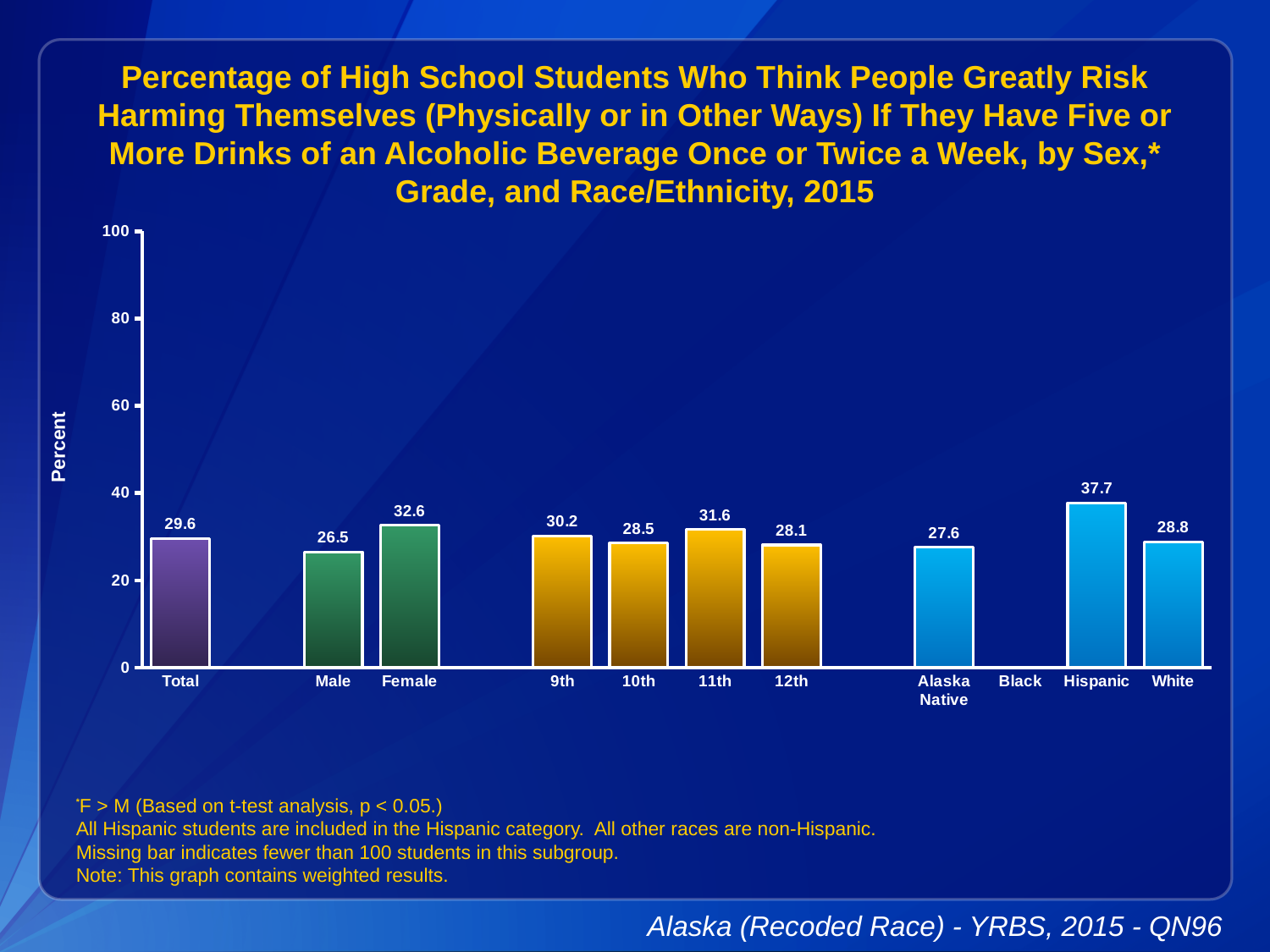
What is the difference between the Female and Male values? 6.1 Which category has no bar shown? Black What is the value for Total? 29.6 What is the value for Female? 32.6 What is the value for 11th grade? 31.6 Which category has the highest value? Hispanic What is the value for Hispanic? 37.7 What is the label on the y axis? Percent Is the value for Hispanic greater or less than 40? less What kind of chart is this? bar chart Which category has the lowest value among those with a bar shown? Male Which is larger, the value for 9th grade or the value for 12th grade? 9th